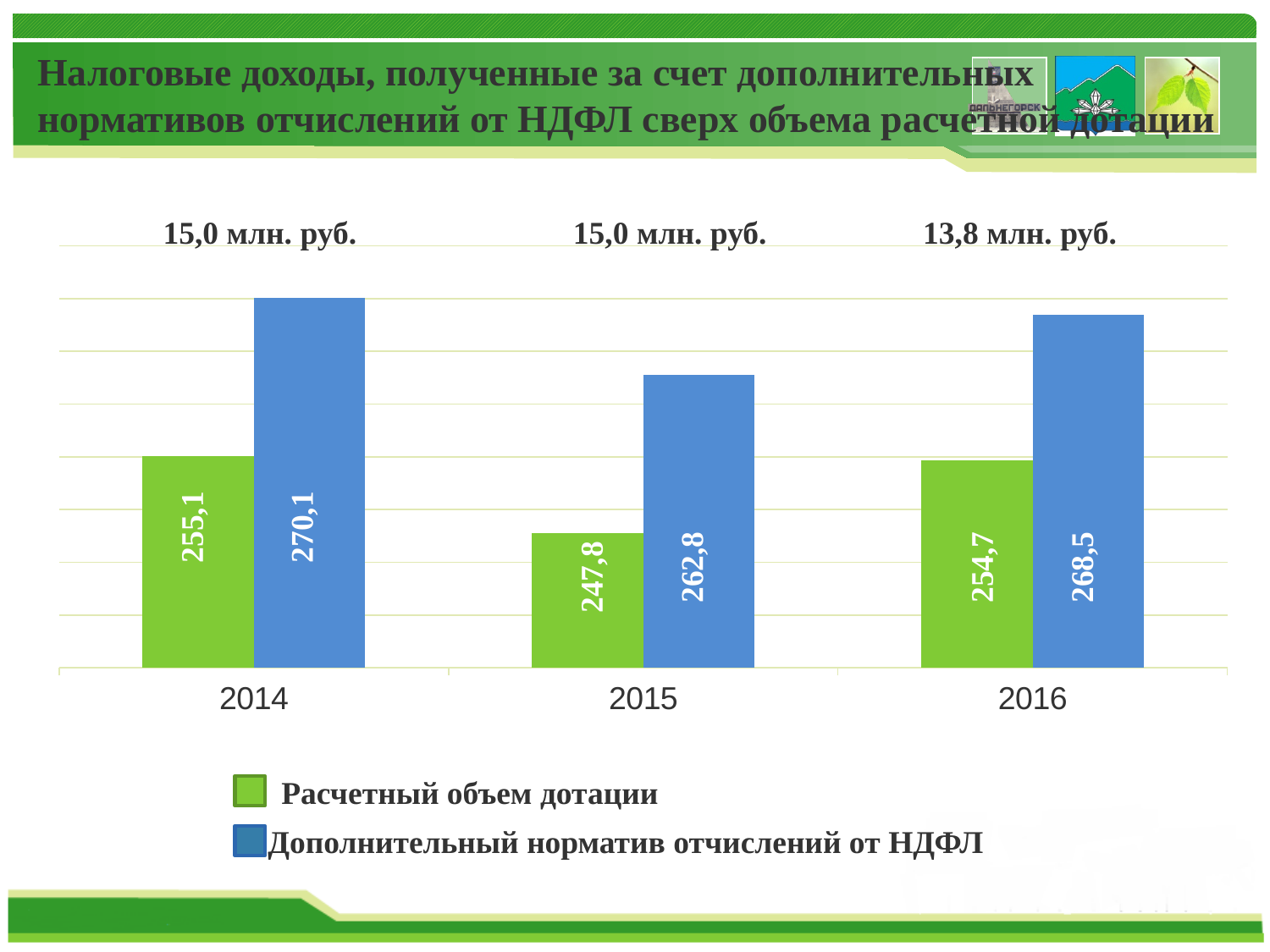
In which year is Расчетный объем дотации the lowest? 2015 What is the value of Расчетный объем дотации for 2016? 254,7 In which year is Дополнительный норматив отчислений от НДФЛ the highest? 2014 How many series does the legend list? 2 Which is larger in 2015: Расчетный объем дотации or Дополнительный норматив отчислений от НДФЛ? Дополнительный норматив отчислений от НДФЛ What is the value of Расчетный объем дотации for 2014? 255,1 What is the difference between Дополнительный норматив отчислений от НДФЛ and Расчетный объем дотации in 2016? 13,8 What is the value of Дополнительный норматив отчислений от НДФЛ for 2016? 268,5 What is the value of Дополнительный норматив отчислений от НДФЛ for 2015? 262,8 How many years are shown on the x axis? 3 Which colour represents Расчетный объем дотации in the legend? green What kind of chart is shown on the slide? bar chart